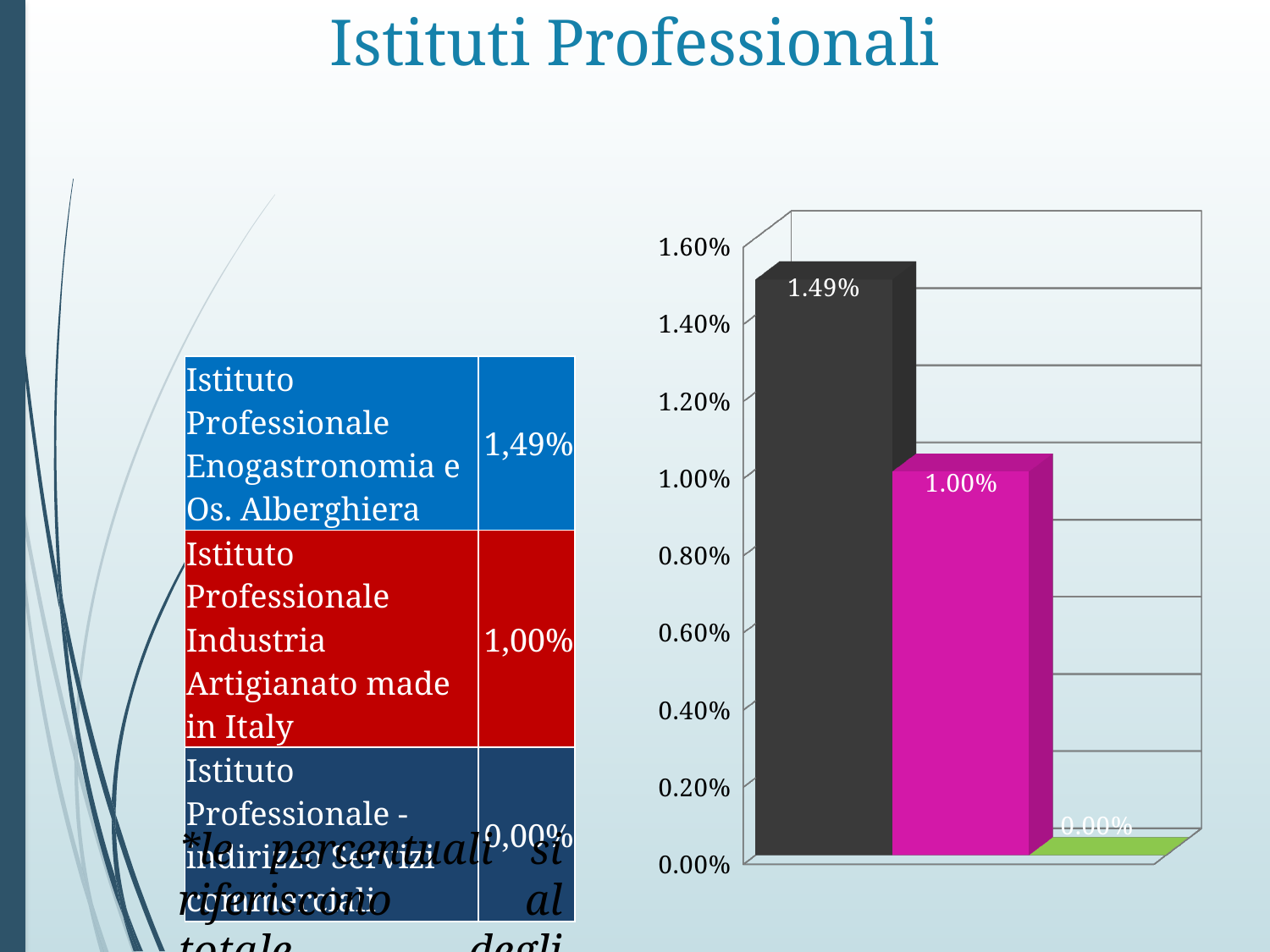
How many bars are plotted in the chart? 3 What type of chart is shown on the slide? bar chart What value is shown on the shortest bar in the chart? 0.00% What value is shown on the tallest bar in the chart? 1.49% What is the difference between the values of the first bar (1.49%) and the second bar (1.00%)? 0.49% What is the value plotted for Istituto Professionale Industria Artigianato made in Italy? 1.00% What is the highest value shown on the chart's vertical axis? 1.60% Which is larger: the value for Istituto Professionale Enogastronomia e Os. Alberghiera or the value for Istituto Professionale Industria Artigianato made in Italy? Istituto Professionale Enogastronomia e Os. Alberghiera What is the value plotted for Istituto Professionale Enogastronomia e Os. Alberghiera? 1.49% Is the value of the first (dark) bar greater or less than 1.40%? greater What is the value shown on the green bar in the chart? 0.00% Do the bar values rise or fall from left to right across the chart? fall